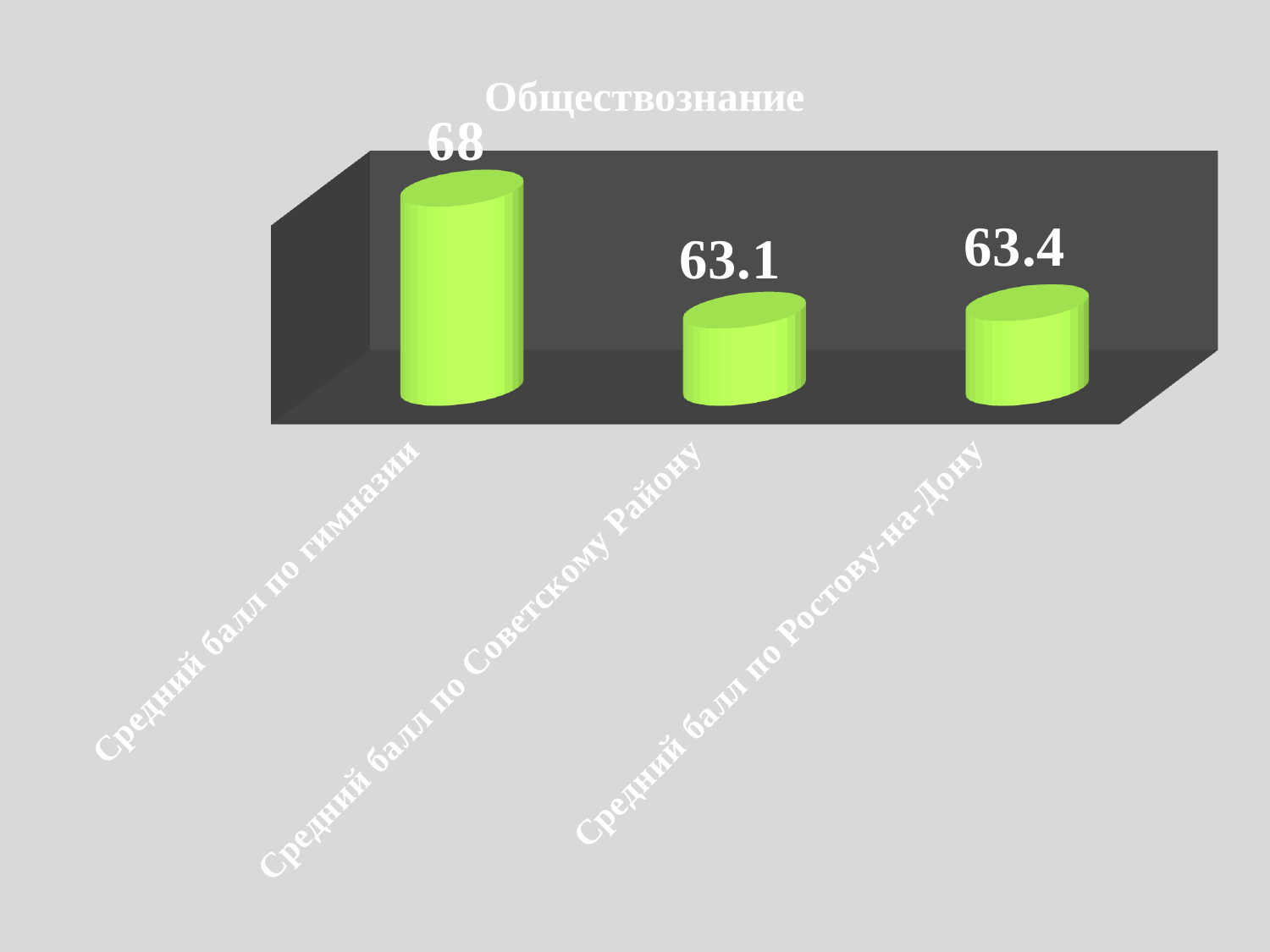
What is the value for Средний балл по Ростову-на-Дону? 63.4 Which is larger: the value for Средний балл по Ростову-на-Дону or the value for Средний балл по Советскому Району? Средний балл по Ростову-на-Дону What is the value for Средний балл по гимназии? 68 What kind of chart is shown on the slide? Bar chart What is the title of the chart? Обществознание What is the value for Средний балл по Советскому Району? 63.1 Which category has the highest value? Средний балл по гимназии How many categories are shown in the chart? 3 What is the difference between the value for Средний балл по гимназии and the value for Средний балл по Советскому Району? 4.9 What is the difference between the value for Средний балл по гимназии and the value for Средний балл по Ростову-на-Дону? 4.6 Which category has the lowest value? Средний балл по Советскому Району What is the difference between the value for Средний балл по Ростову-на-Дону and the value for Средний балл по Советскому Району? 0.3